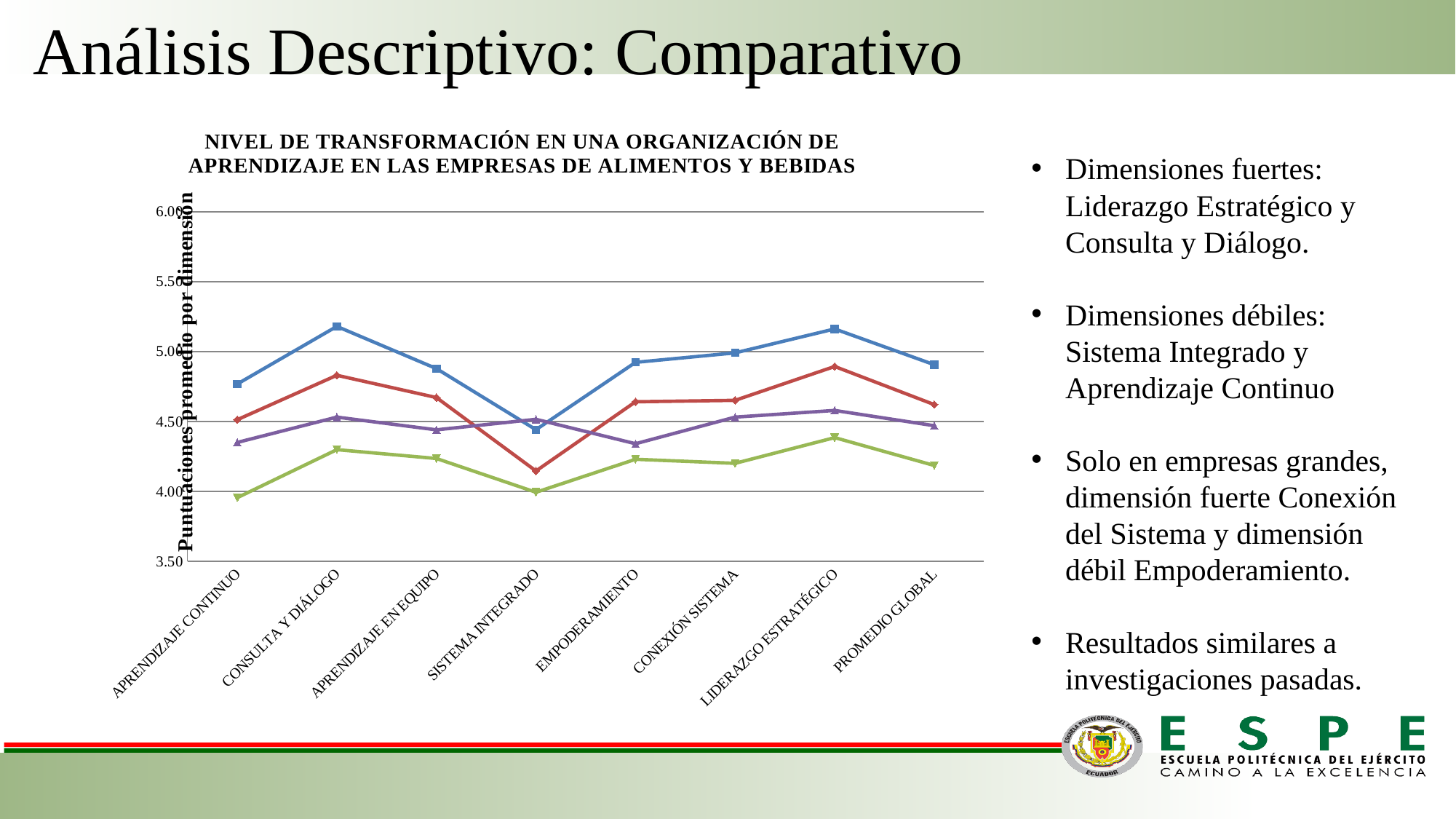
What is the label of the vertical axis of the chart? Puntuaciones promedio por dimensión Is the value of the blue line for CONSULTA Y DIÁLOGO greater or less than 5.00? greater Is the value of the green line for CONSULTA Y DIÁLOGO greater or less than 4.00? greater What kind of chart is shown on the slide? line chart Which line has the lowest value at every category: the blue, red, purple or green line? green For which category does the red line reach its lowest value? SISTEMA INTEGRADO How many categories are shown along the x axis of the chart? 8 Does the blue line rise or fall from SISTEMA INTEGRADO to EMPODERAMIENTO? rise Is the value of the blue line for SISTEMA INTEGRADO greater or less than 4.50? less For which category does the blue line reach its lowest value? SISTEMA INTEGRADO How many lines are plotted on the chart? 4